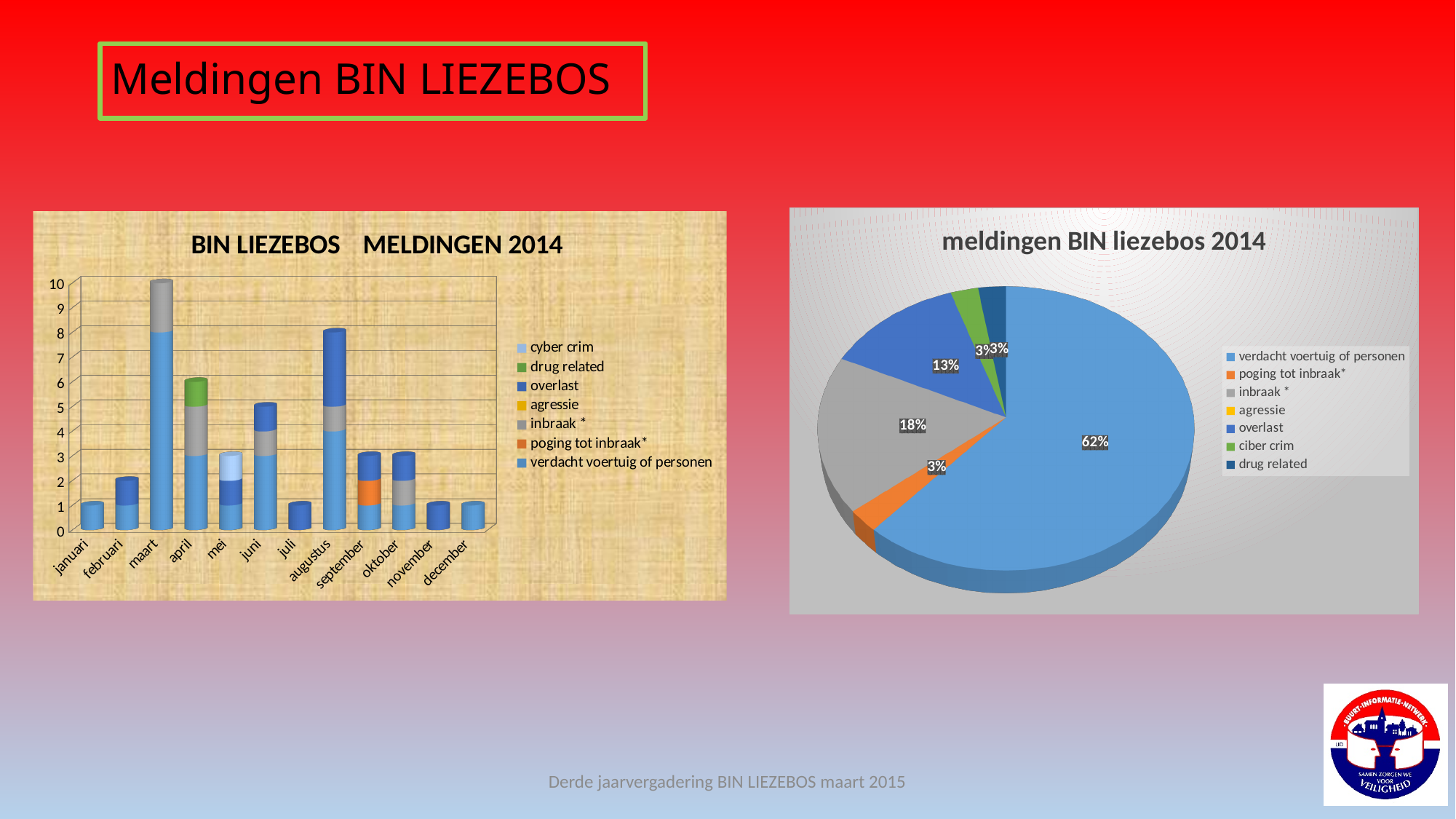
In the right pie chart, what share does 'verdacht voertuig of personen' have? 62% In the left bar chart, what is the total height of the bar for maart? 10 In the right pie chart, what share does 'inbraak *' have? 18% What kind of chart is the right chart titled 'meldingen BIN liezebos 2014'? Pie chart What kind of chart is the left chart titled 'BIN LIEZEBOS MELDINGEN 2014'? Stacked bar chart In the left bar chart, how many series does the legend list? 7 In the left bar chart, is the total for april greater or less than 5? greater In the left bar chart, which month has the highest total number of meldingen? maart In the left bar chart, what is the total height of the bar for augustus? 8 In the left bar chart, which bar is taller, maart or augustus? maart In the left bar chart, how many months are shown on the x axis? 12 In the right pie chart, what is the difference in percentage points between 'verdacht voertuig of personen' and 'overlast'? 49